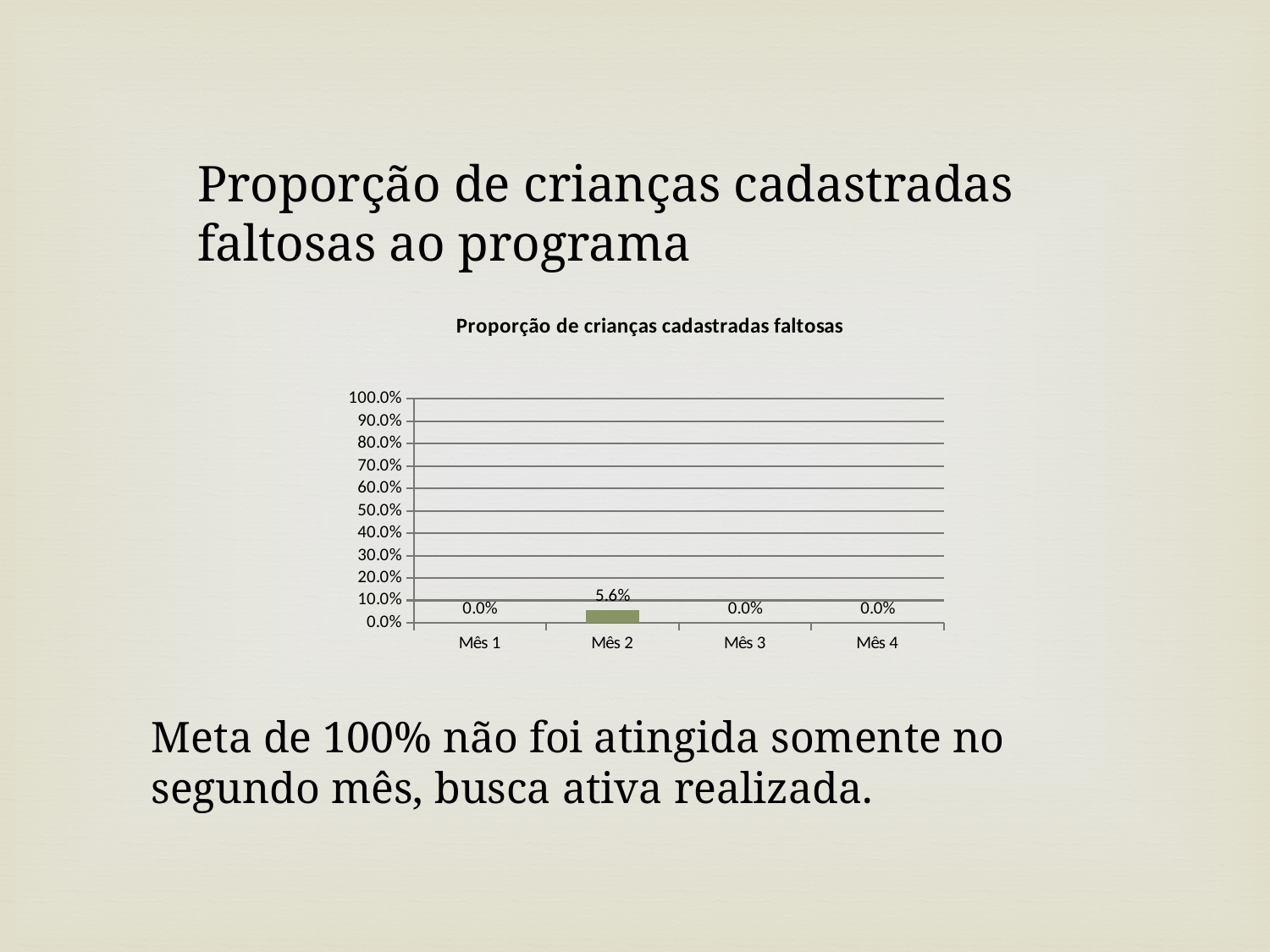
Which is larger, the value for Mês 2 or the value for Mês 1? Mês 2 What is the value for Mês 2? 5.6% What is the highest value shown on the y axis? 100.0% How many months are shown on the x axis? 4 Is the value for Mês 2 greater or less than 10.0%? less What is the title of the chart? Proporção de crianças cadastradas faltosas What is the value for Mês 4? 0.0% How many months have a value of 0.0%? 3 What is the difference between the values for Mês 2 and Mês 3? 5.6% What is the value for Mês 1? 0.0% Which month has the highest value? Mês 2 What kind of chart is shown on the slide? bar chart